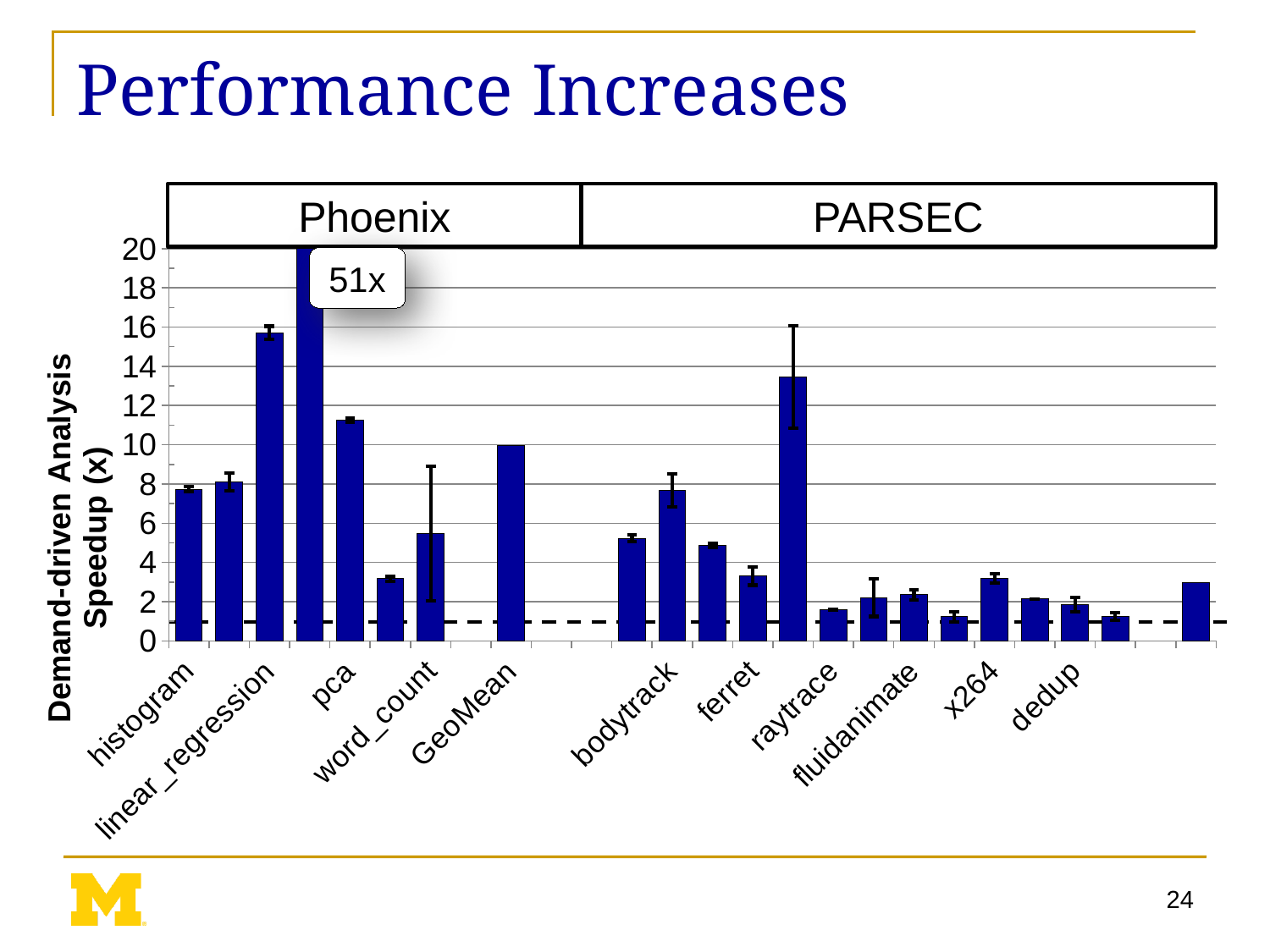
Is the value for GeoMean greater or less than 8? greater What are the two benchmark group labels shown above the chart? Phoenix and PARSEC What is the title of the vertical axis of the chart? Demand-driven Analysis Speedup (x) What kind of chart is shown on the slide? bar chart Is the value for histogram greater or less than 6? greater Is the value for ferret greater or less than 6? less What value is annotated on the tallest bar in the chart? 51x Which benchmark group, Phoenix or PARSEC, contains the tallest bar? Phoenix What is the highest tick value shown on the vertical axis? 20